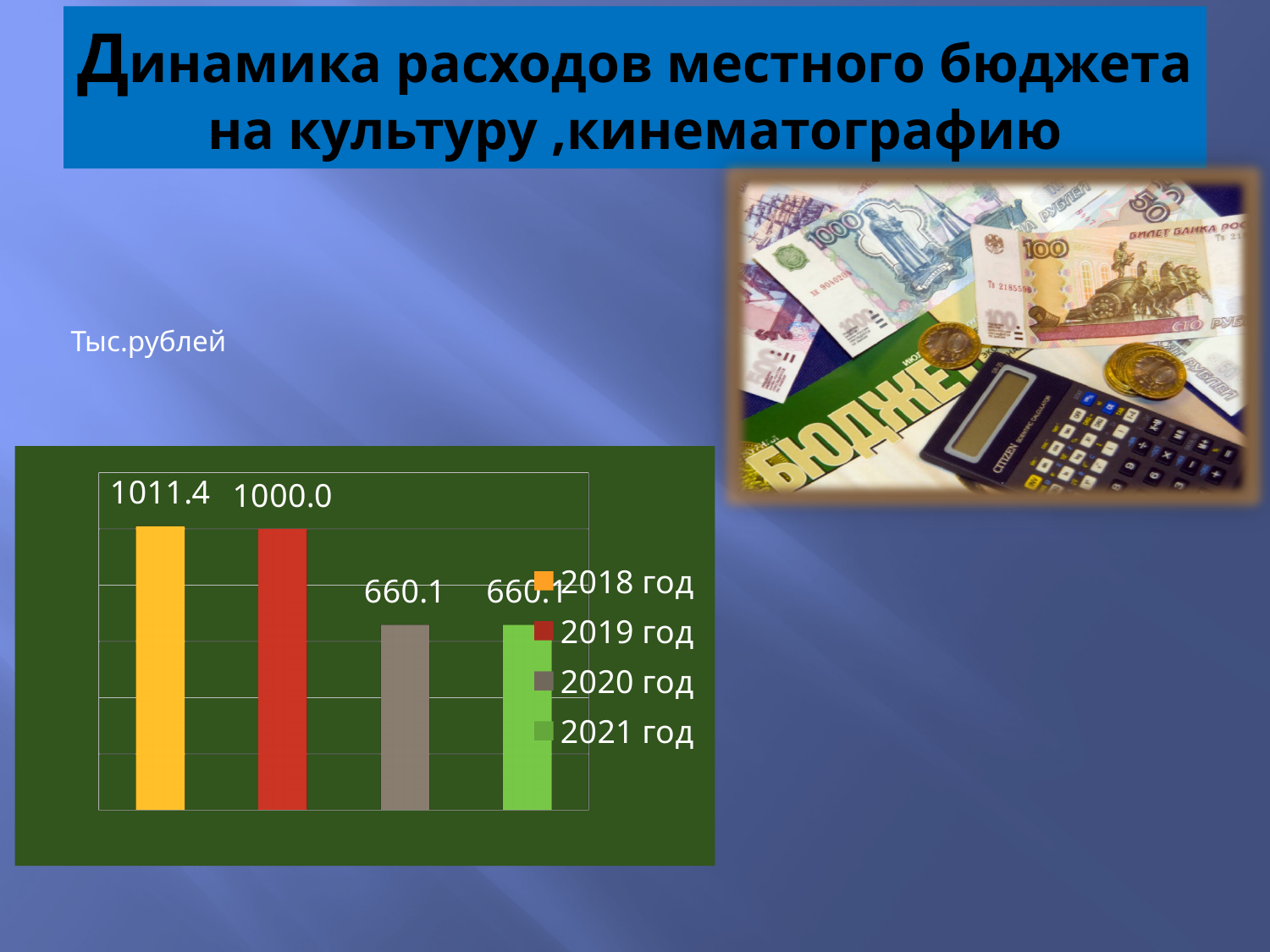
What is the value for 2020 год? 660.1 What is the difference between the values for 2018 год and 2019 год? 11.4 What unit is stated for the chart values? Тыс.рублей How many bars are shown in the chart? 4 What is the value for 2021 год? 660.1 Which is larger, the value for 2018 год or the value for 2019 год? 2018 год How many entries does the legend list? 4 What is the value for 2019 год? 1000.0 What is the difference between the values for 2019 год and 2020 год? 339.9 What is the value for 2018 год? 1011.4 Which year has the highest value? 2018 год What kind of chart is shown on the slide? Bar chart